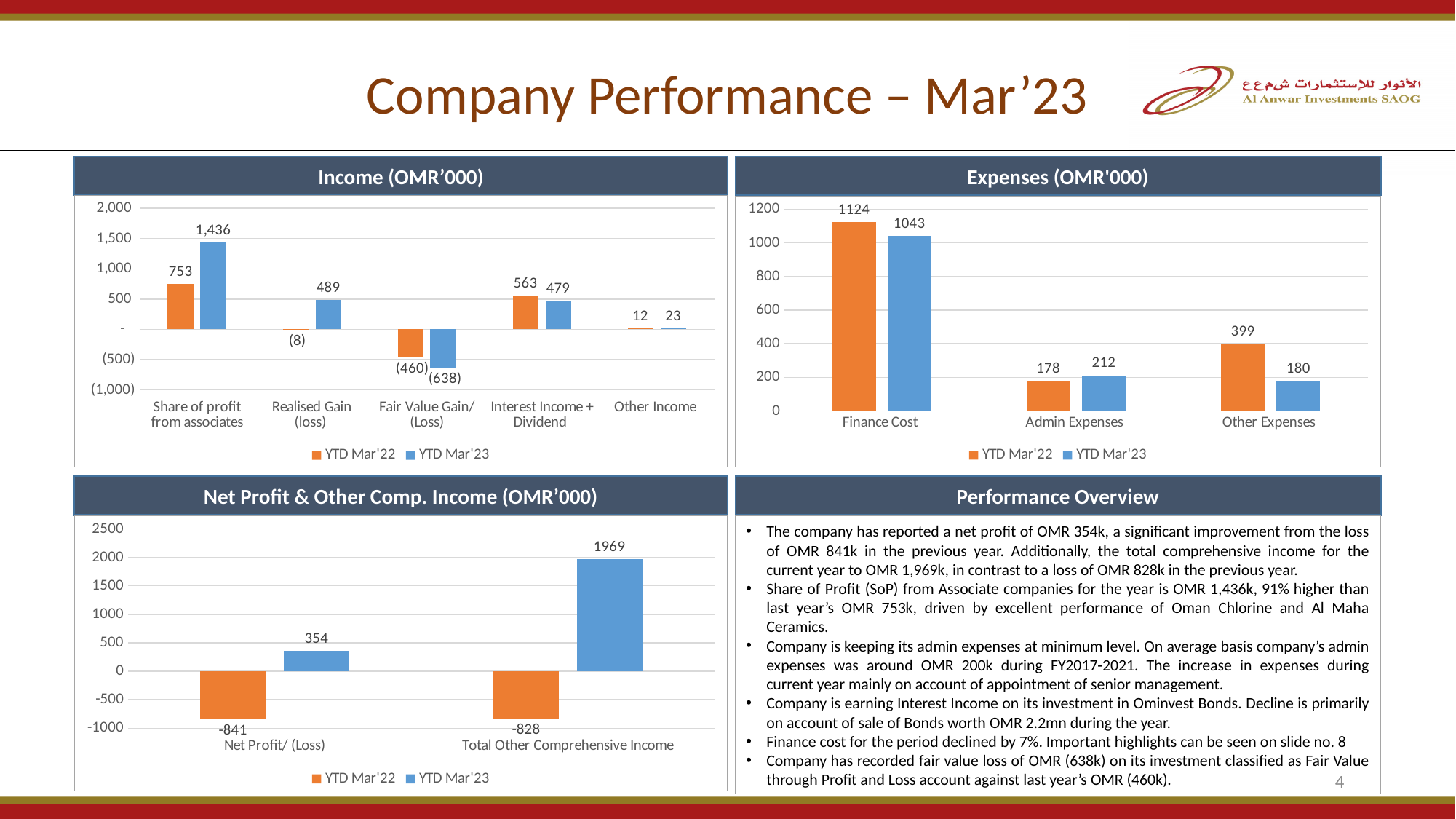
In the Income (OMR'000) chart, what is the difference between the YTD Mar'23 and YTD Mar'22 values for Interest Income + Dividend? 84 In the Expenses (OMR'000) chart, which category has the lowest YTD Mar'23 value? Other Expenses In the Income (OMR'000) chart, what is the YTD Mar'22 value for Fair Value Gain/(Loss)? (460) In the Expenses (OMR'000) chart, what is the YTD Mar'22 value for Finance Cost? 1124 In the Net Profit & Other Comp. Income (OMR'000) chart, what is the YTD Mar'23 value for Total Other Comprehensive Income? 1969 In the Expenses (OMR'000) chart, is the YTD Mar'22 value for Other Expenses larger or smaller than the YTD Mar'23 value? larger In the Net Profit & Other Comp. Income (OMR'000) chart, what is the YTD Mar'22 value for Net Profit/(Loss)? -841 How many series does the legend of the Net Profit & Other Comp. Income (OMR'000) chart list? 2 In the Income (OMR'000) chart, how many categories are shown on the x axis? 5 In the Income (OMR'000) chart, what is the YTD Mar'23 value for Share of profit from associates? 1,436 In the Expenses (OMR'000) chart, what is the difference between the YTD Mar'22 and YTD Mar'23 values for Finance Cost? 81 In the Income (OMR'000) chart, which category has the highest YTD Mar'23 value? Share of profit from associates